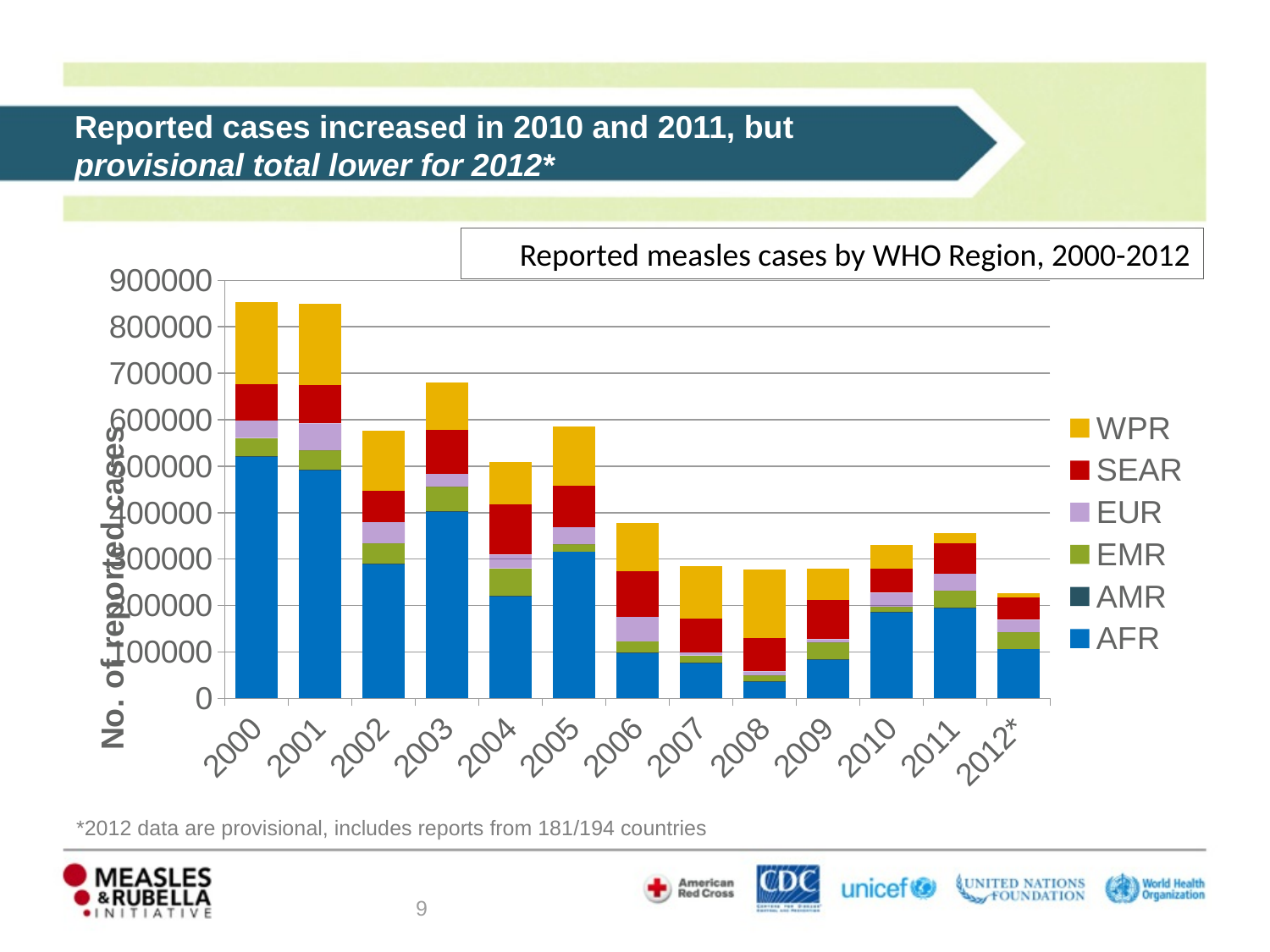
Which WHO region is shown at the bottom of each stacked bar? AFR Is the total number of reported cases for 2000 greater or less than 800000? greater Which year has the larger total of reported cases, 2003 or 2004? 2003 Is the total number of reported cases for 2008 greater or less than 300000? less What kind of chart is shown on the slide? Stacked bar chart What is the title of the chart? Reported measles cases by WHO Region, 2000-2012 Which year has the lowest total of reported cases? 2012* Is the total number of reported cases for 2003 greater or less than 600000? greater How many years (categories) are shown on the x axis? 13 How many series does the legend list? 6 Overall, do the total reported cases rise or fall from 2000 to 2012? fall